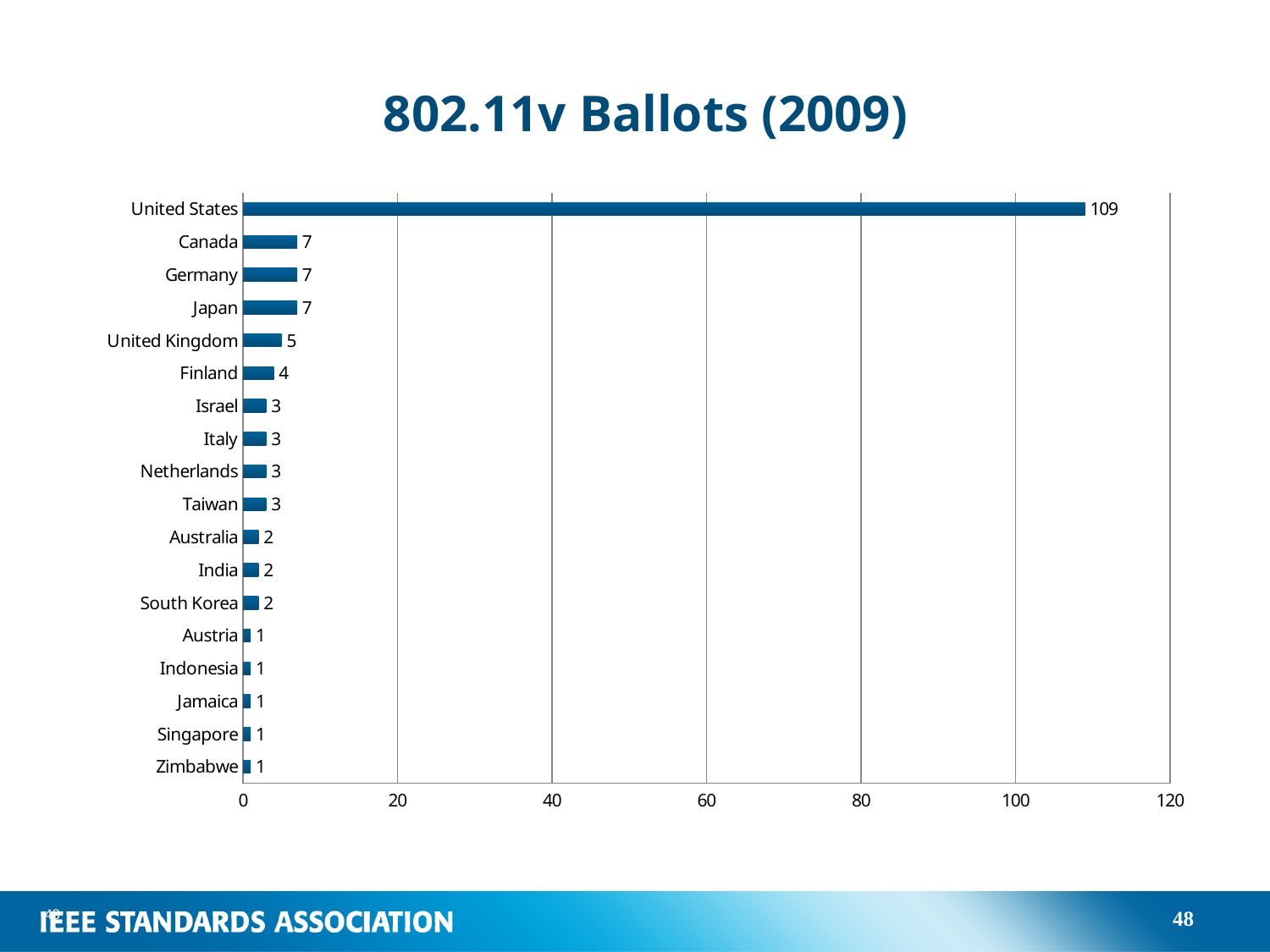
What is the value for the United Kingdom? 5 What is the value for the United States? 109 How many countries have a value of 1? 5 Is the value for the United States greater or less than 100? greater What is the difference between the values for Japan and Taiwan? 4 What is the title of the chart? 802.11v Ballots (2009) What is the difference between the values for the United States and Canada? 102 How many countries are shown on the chart? 18 What is the value for Finland? 4 What kind of chart is shown on the slide? bar chart Which country has the highest number of ballots? United States Which is larger, the value for Finland or the value for Israel? Finland